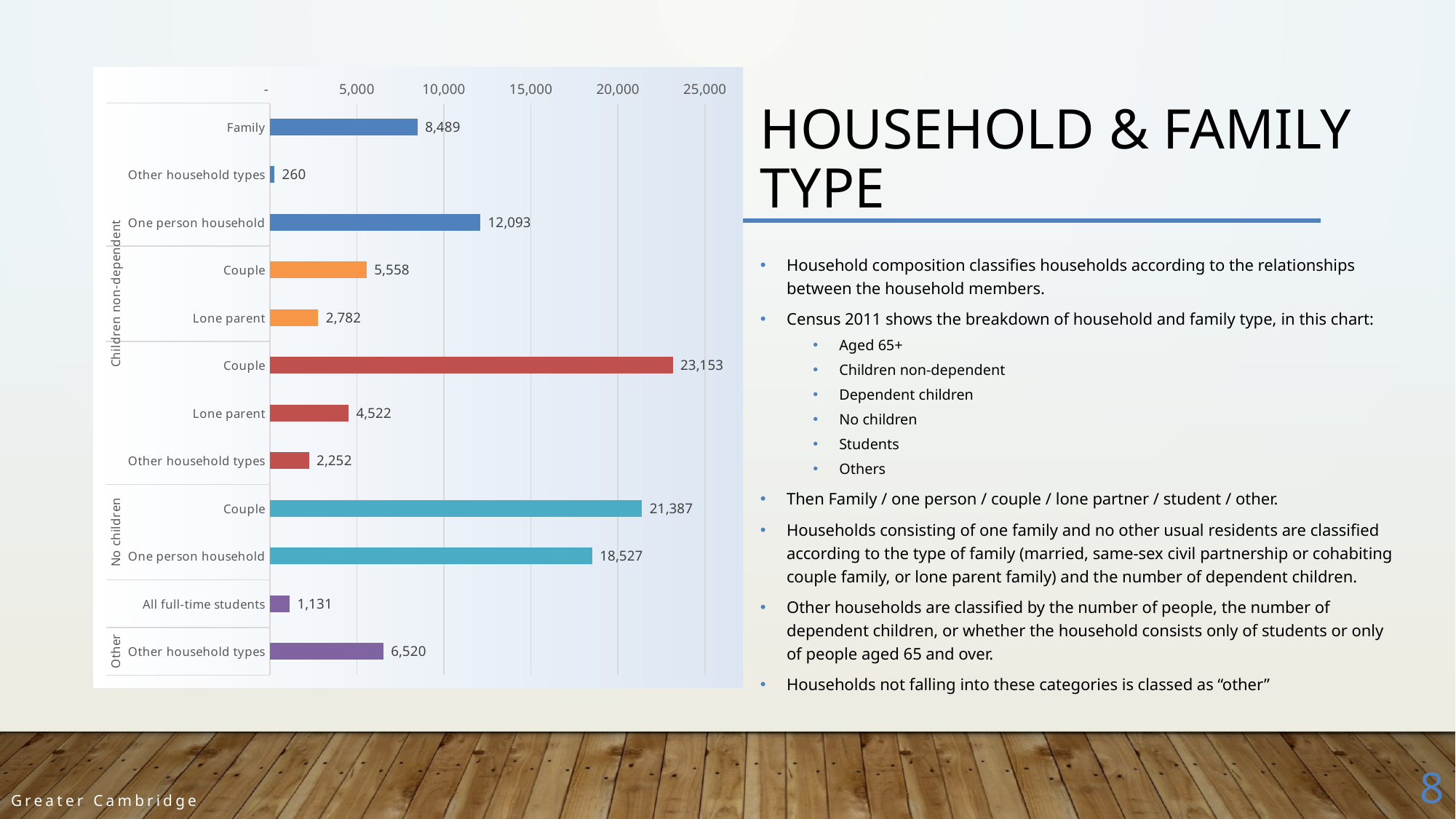
Which is larger: Family (8,489) or the blue One person household bar at the top of the chart? One person household What is the value for All full-time students? 1,131 What is the value for One person household in the No children group? 18,527 What is the value for Family in the chart? 8,489 In the No children group, what is the difference between Couple and One person household? 2,860 In the Children non-dependent group, what is the difference between Couple and Lone parent? 2,776 How many bars are plotted in the chart? 12 What kind of chart is shown on the slide? bar chart What is the value for Couple in the Children non-dependent group? 5,558 What is the value of the shortest bar in the chart? 260 What is the value of the longest bar in the chart? 23,153 Is the value for Other household types in the Other group (purple bar) greater or less than 5,000? greater